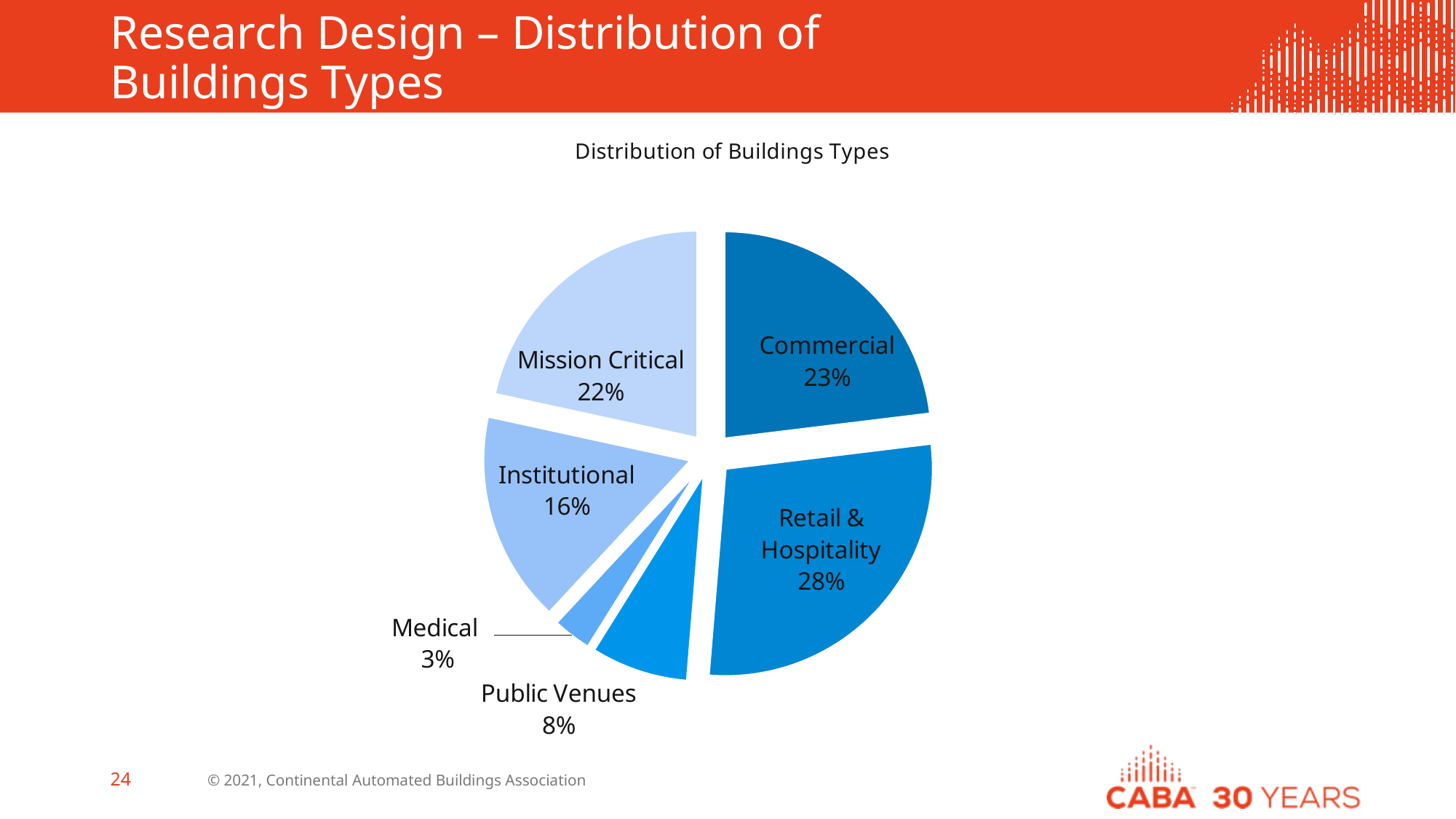
What is the value shown for Commercial? 23% Which is larger, the share for Institutional or the share for Public Venues? Institutional What is the value shown for Mission Critical? 22% What kind of chart is shown on the slide? Pie chart What share of the pie does Retail & Hospitality represent? 28% What is the value shown for Institutional? 16% Which building type has the largest share of the pie? Retail & Hospitality What is the value shown for Medical? 3% What is the difference in percentage points between Retail & Hospitality and Commercial? 5 Which building type has the smallest share of the pie? Medical What is the title of the chart? Distribution of Buildings Types How many building types are shown in the pie chart? 6